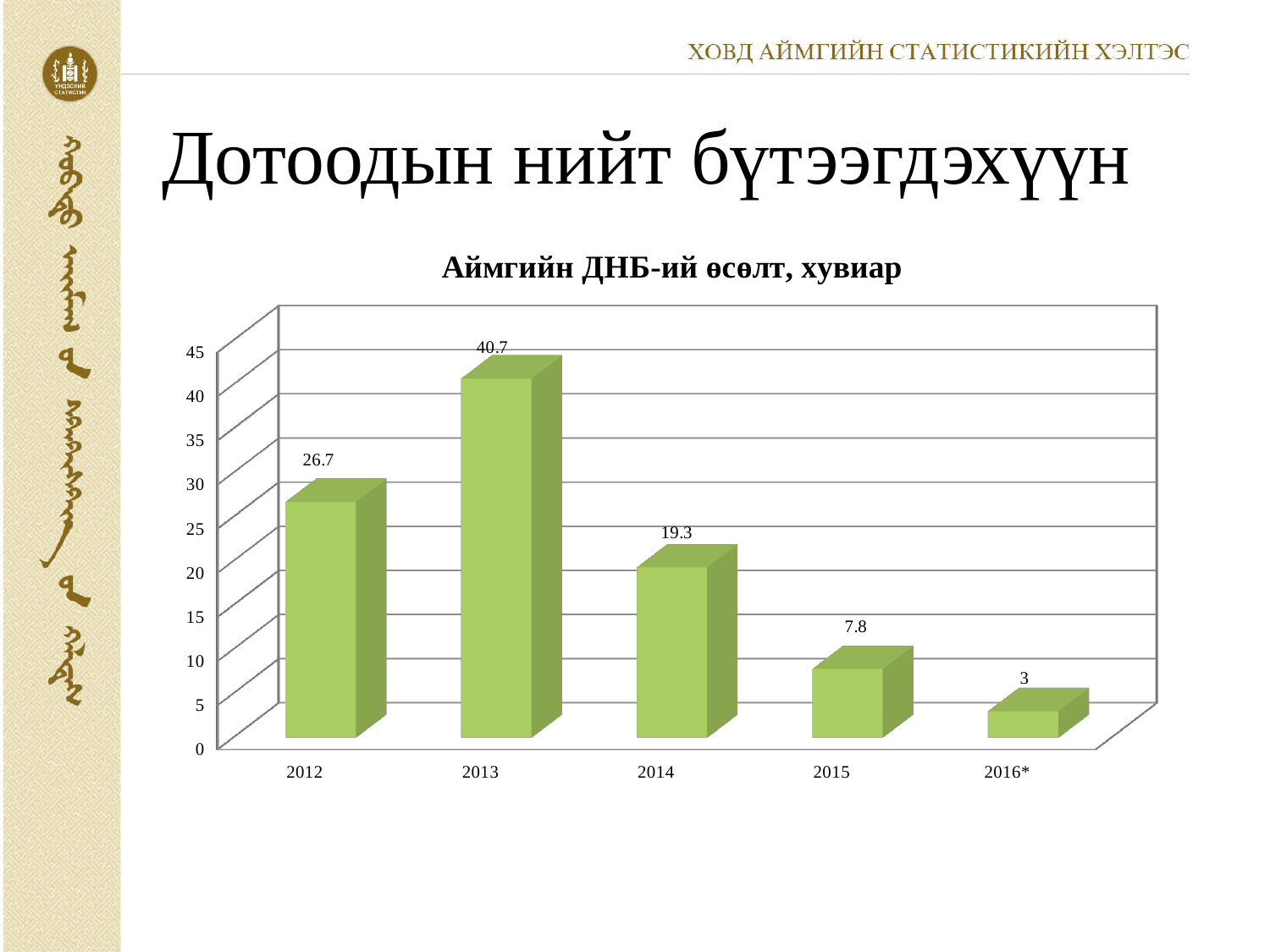
Which year has the highest value? 2013 What is the difference between the values for 2013 and 2012? 14 How many years are shown on the x axis? 5 What kind of chart is shown on the slide? Bar chart Which is larger, the value for 2014 or the value for 2015? 2014 What is the value for 2012? 26.7 What is the value for 2014? 19.3 Do the values rise or fall from 2013 to 2016*? Fall Which year has the lowest value? 2016* What is the value for 2013? 40.7 What is the value for 2016*? 3 What is the value for 2015? 7.8